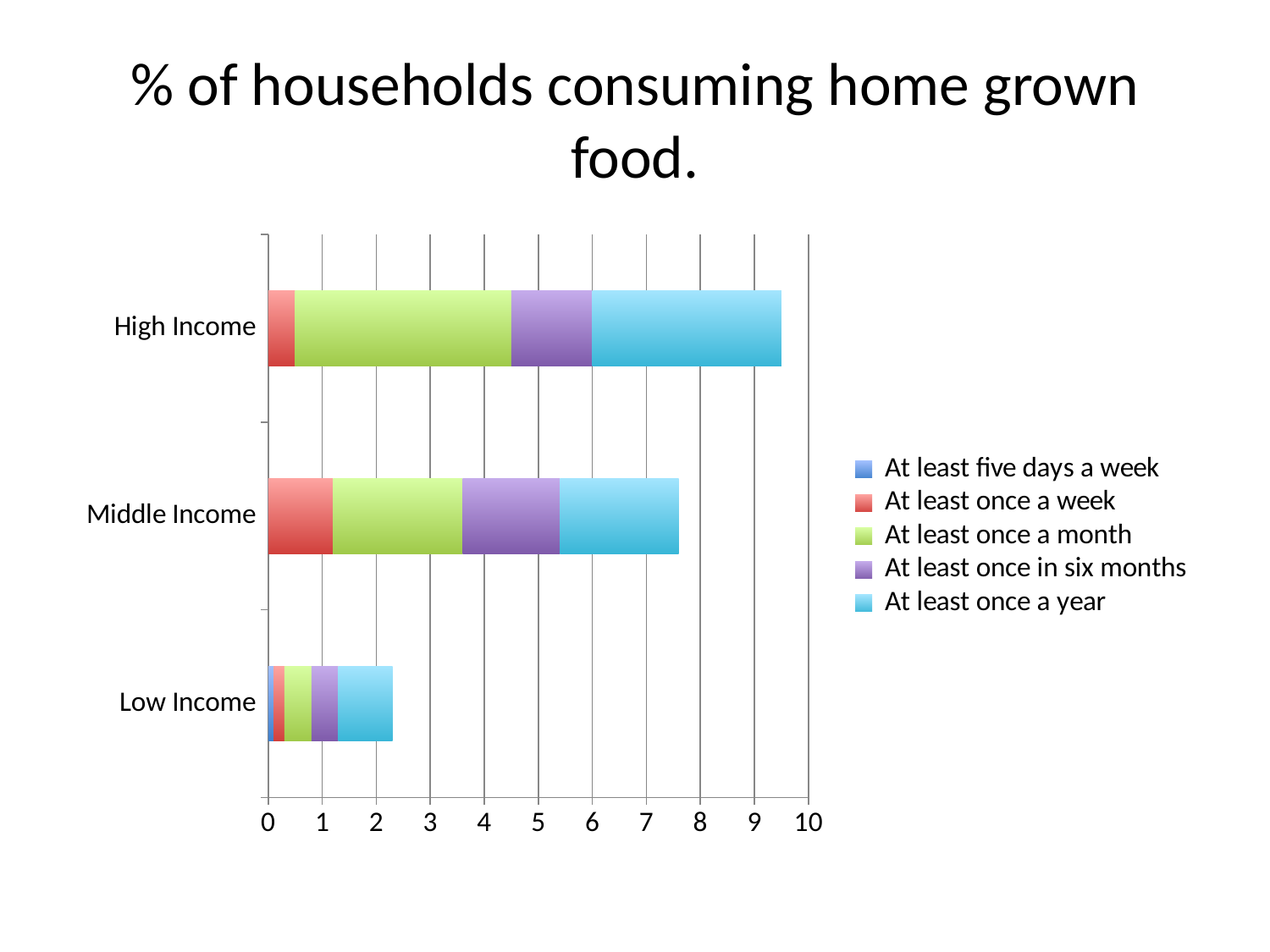
How many income categories are plotted on the chart? 3 Is the total bar length for Middle Income greater or less than 8? less Is the total bar length for Low Income greater or less than 3? less What is the title of the chart? % of households consuming home grown food. Which income category has the longest total bar? High Income How many series does the legend list? 5 What kind of chart is shown on the slide? Stacked bar chart Which has a longer total bar, Middle Income or Low Income? Middle Income Is the total bar length for High Income greater or less than 9? greater Which has a longer total bar, High Income or Middle Income? High Income Which legend entry is shown in light blue? At least once a year Which income category has the shortest total bar? Low Income